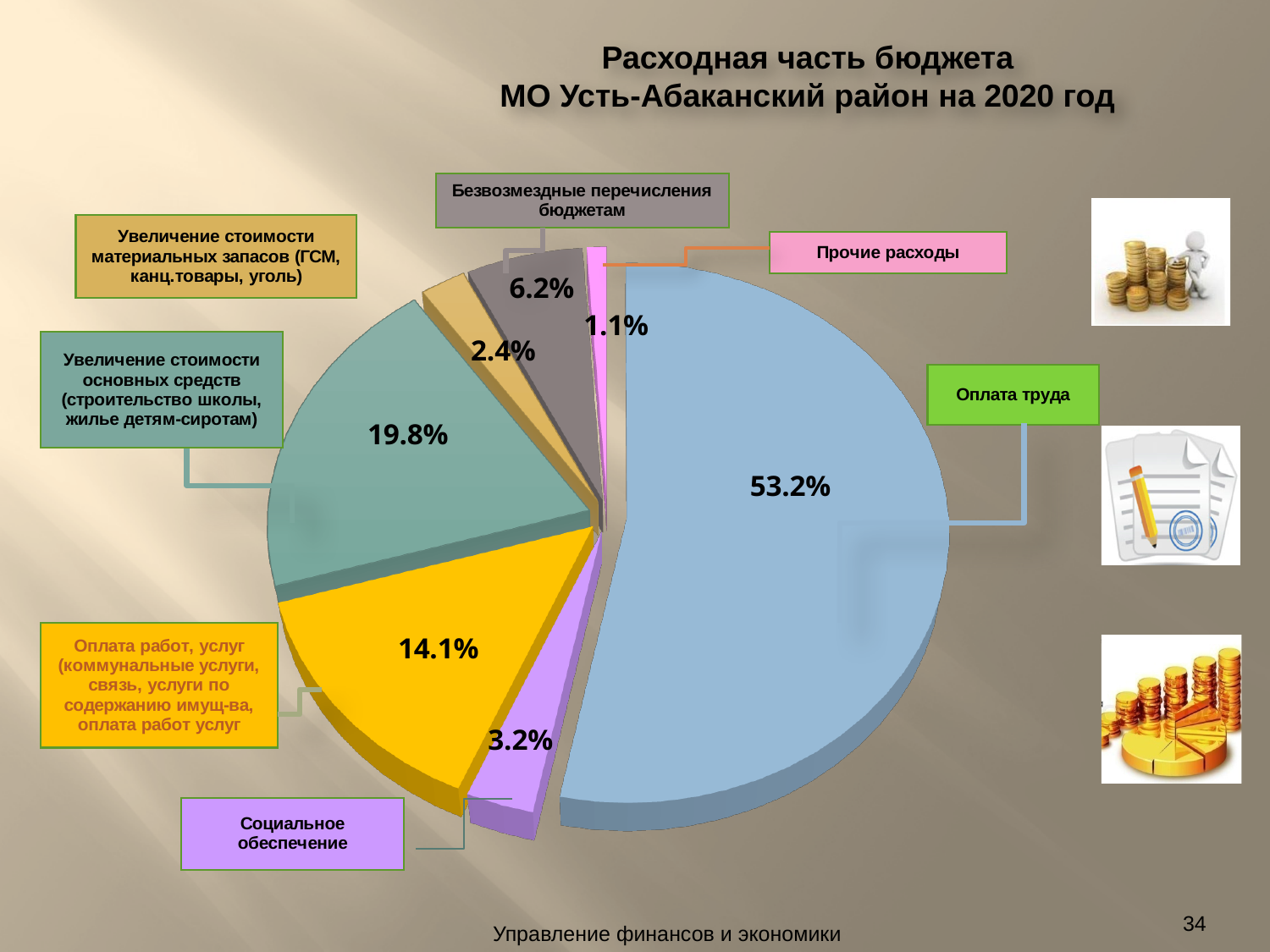
What is the difference in percentage points between Оплата труда and Оплата работ, услуг? 39.1 Which category has the largest share of the pie? Оплата труда How many slices does the pie chart have? 7 What is the title of the chart on the slide? Расходная часть бюджета МО Усть-Абаканский район на 2020 год Which is larger: the share for Безвозмездные перечисления бюджетам or the share for Увеличение стоимости материальных запасов? Безвозмездные перечисления бюджетам What percentage is shown for Увеличение стоимости основных средств (строительство школы, жилье детям-сиротам)? 19.8% Which category has the smallest share of the pie? Прочие расходы What percentage is shown for Социальное обеспечение? 3.2% What percentage is shown for Прочие расходы? 1.1% What kind of chart is shown on the slide? pie chart What percentage is shown for Безвозмездные перечисления бюджетам? 6.2% What share of the budget expenditure is labelled for Оплата труда? 53.2%